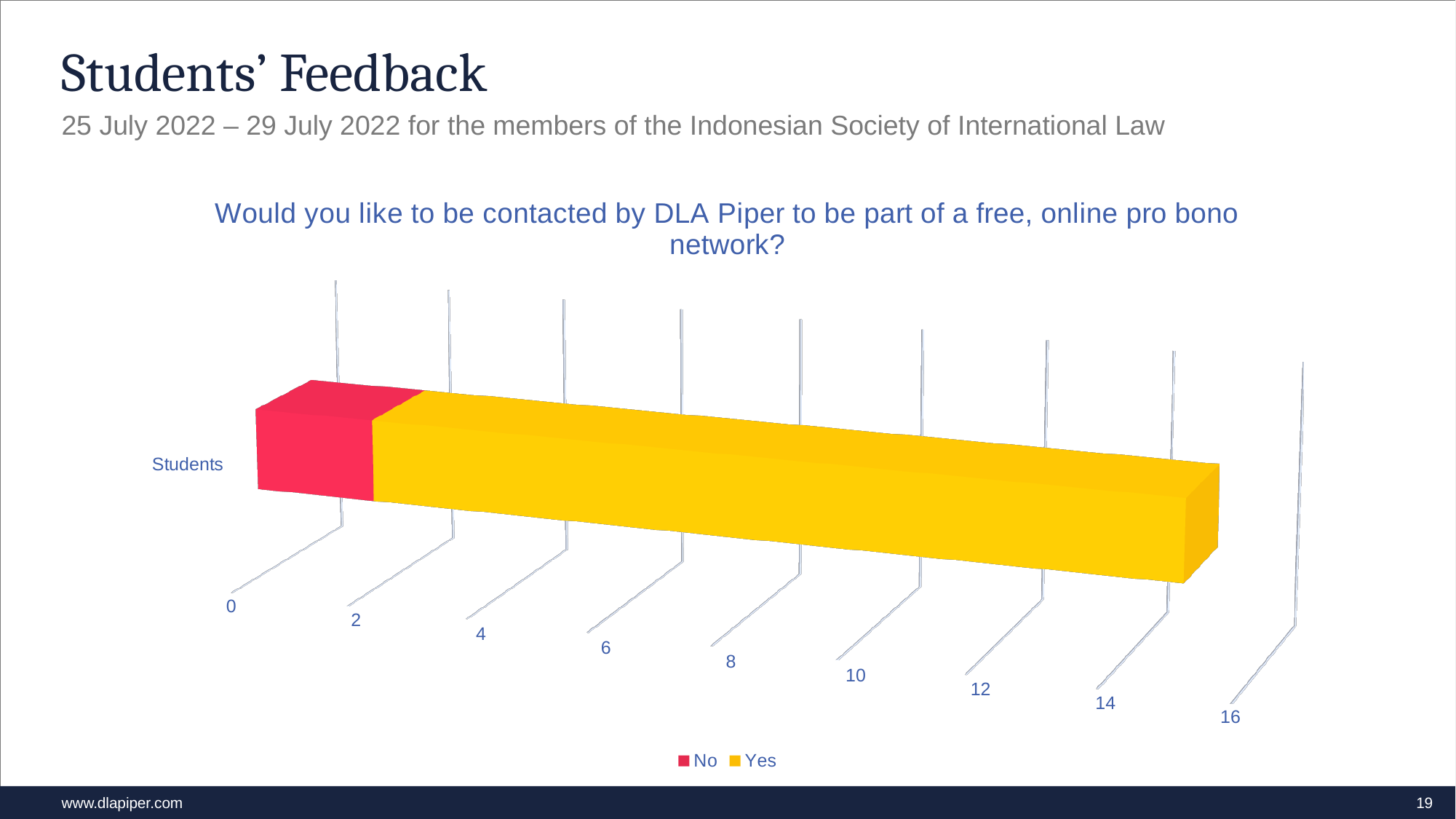
What is the label of the single category on the chart? Students Is the value for Yes greater or less than 8? greater Is the value for No greater or less than 4? less How many categories are plotted on the chart? 1 What kind of chart is shown on the slide? Bar chart Which series has the smallest value for Students? No Which series has the larger value for Students, No or Yes? Yes What is the title of the chart? Would you like to be contacted by DLA Piper to be part of a free, online pro bono network? Is the total length of the Students bar greater or less than 12? greater What colour represents the Yes series? Yellow Which series has the largest value for Students? Yes How many series does the legend list? 2